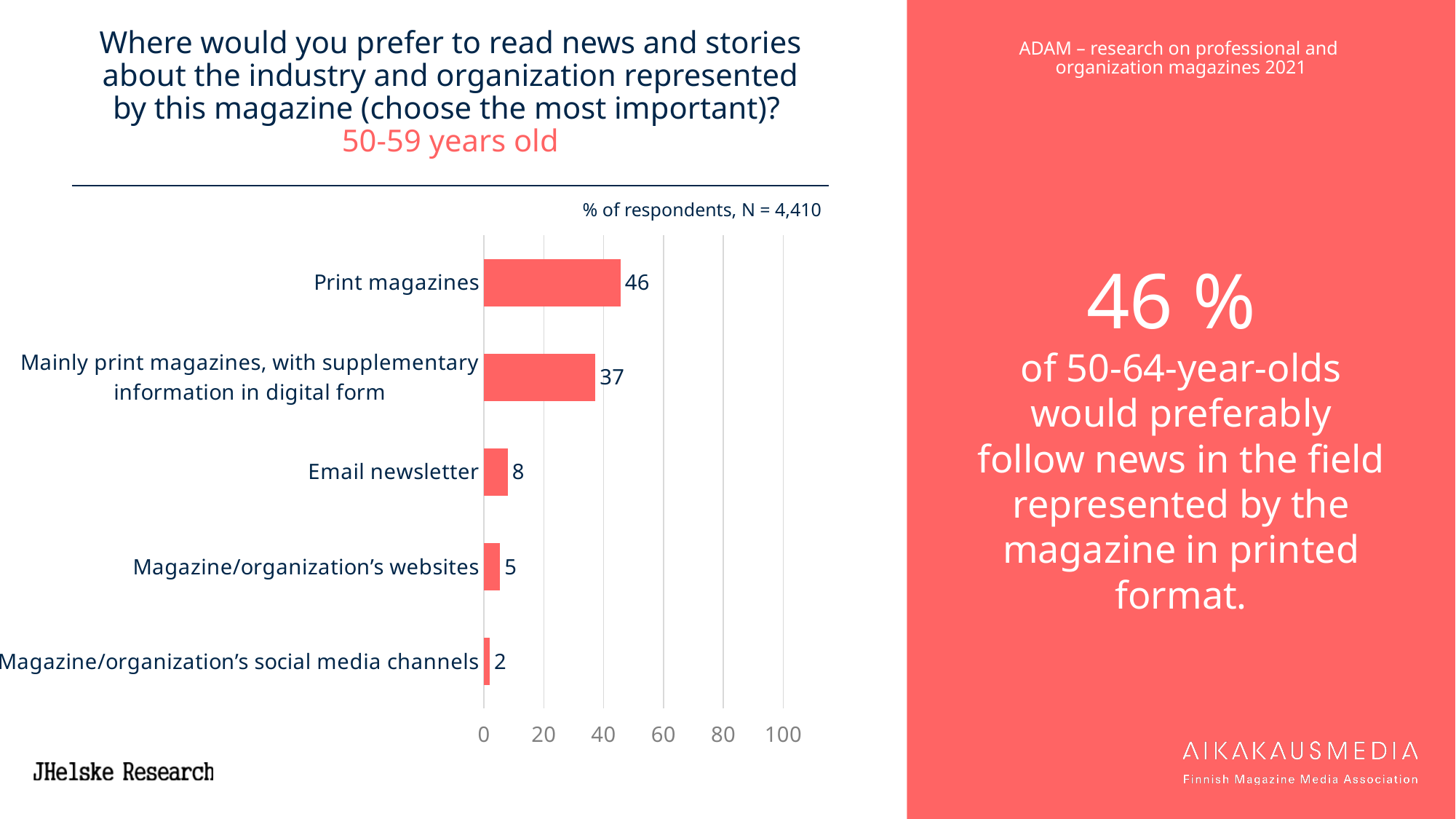
What is the difference between the values for Print magazines and Mainly print magazines, with supplementary information in digital form? 9 Is the value for Mainly print magazines, with supplementary information in digital form greater or less than 40? less What kind of chart is shown on the slide? bar chart What is the value for Email newsletter? 8 Which category has the highest value? Print magazines What is the value for Magazine/organization's social media channels? 2 How many categories are shown in the chart? 5 What is the sample size (N) stated above the chart? 4,410 Which is larger: the value for Email newsletter or the value for Magazine/organization's websites? Email newsletter What percentage of respondents chose Print magazines? 46 Which age group does the chart cover, according to the subtitle? 50-59 years old Which category has the lowest value? Magazine/organization's social media channels